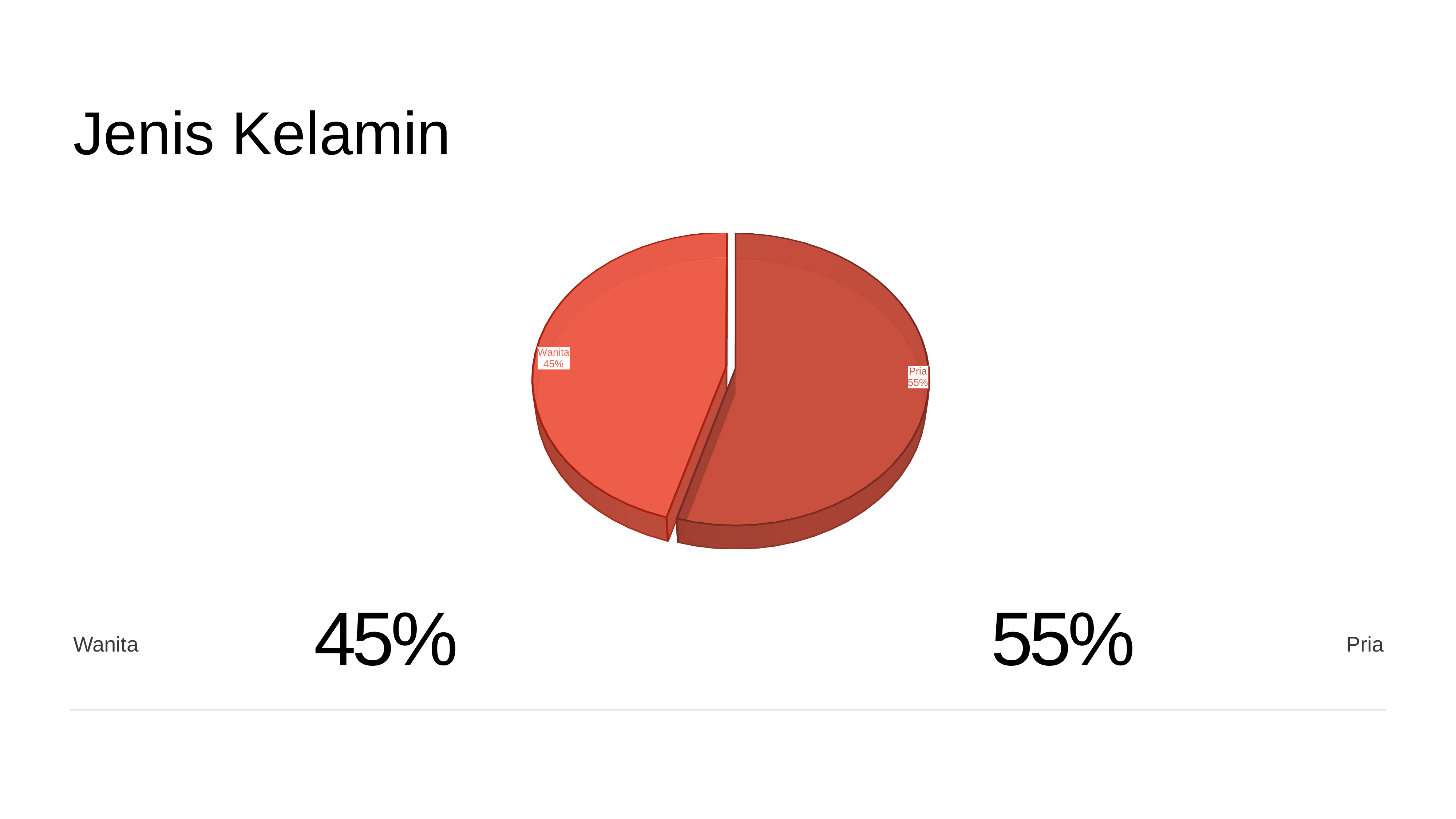
How many slices does the pie chart have? 2 Is the Wanita slice greater or less than 50%? less Which category has the largest slice of the pie? Pria What is the difference in percentage points between the Pria and Wanita slices? 10 What share of the pie does Pria represent? 55% Which is larger, the Wanita slice or the Pria slice? Pria What kind of chart is shown on the slide? pie chart What share of the pie does Wanita represent? 45% What is the title of the slide containing the pie chart? Jenis Kelamin Is the Pria slice greater or less than 50%? greater Which category has the smallest slice of the pie? Wanita